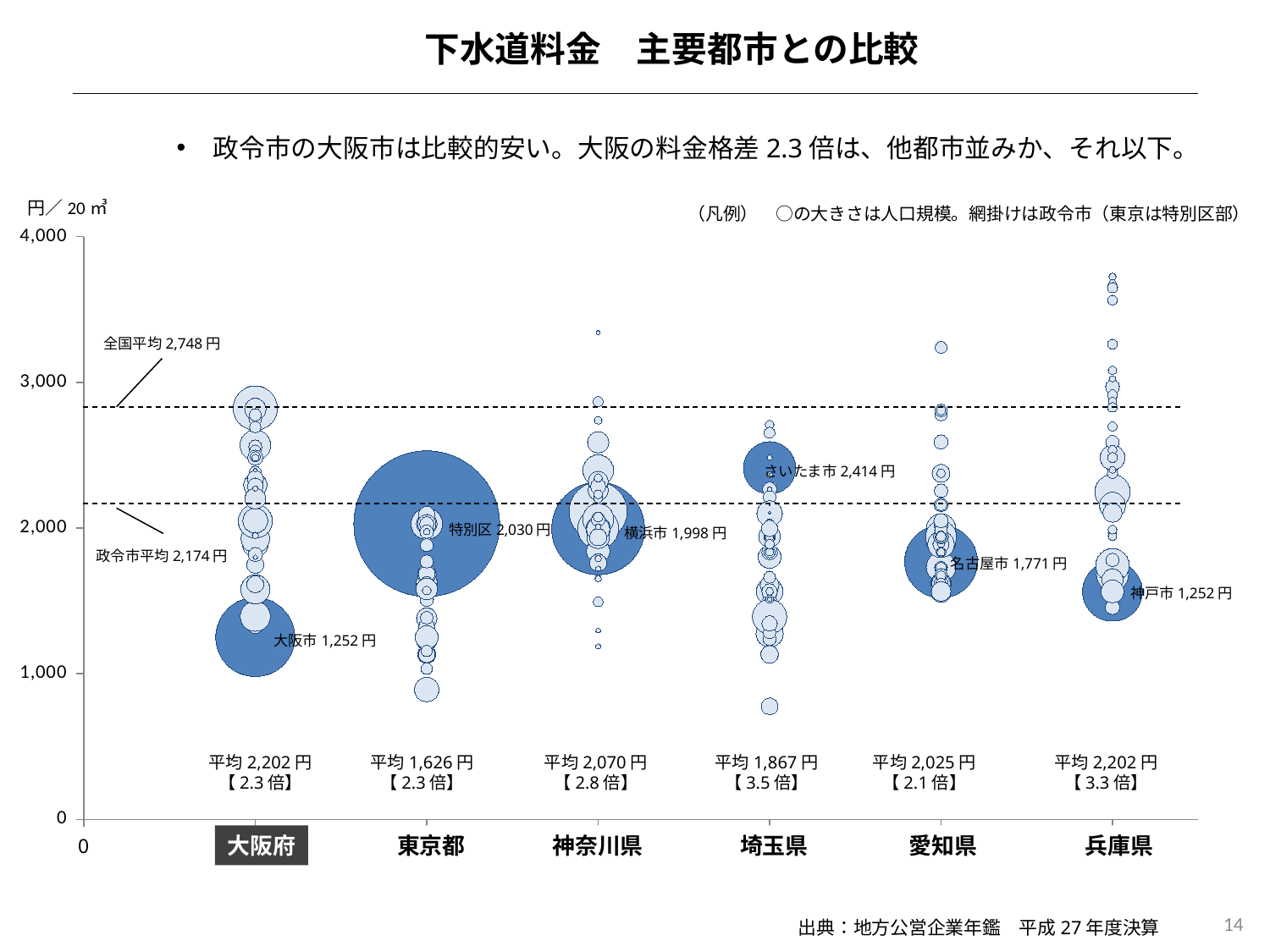
Which is larger, the average fee for 神奈川県 or the average fee for 愛知県? 神奈川県 According to the legend, what does the size of each circle represent? 人口規模 What is the sewerage fee shown for さいたま市? 2,414 円 How many prefectures are shown on the x axis? 6 What is the average (平均) fee shown for 東京都? 1,626 円 Which prefecture has the lowest average (平均) fee among the six shown? 東京都 What is the difference between the national average (全国平均) and the designated-city average (政令市平均)? 574 円 What is the difference between the fee for 特別区 and the fee for 横浜市? 32 円 What is the fee ratio (倍) shown for 埼玉県? 3.5 倍 Which labelled designated city (政令市) has the highest fee? さいたま市 What is the sewerage fee shown for 大阪市? 1,252 円 What is the national average (全国平均) fee shown on the chart? 2,748 円